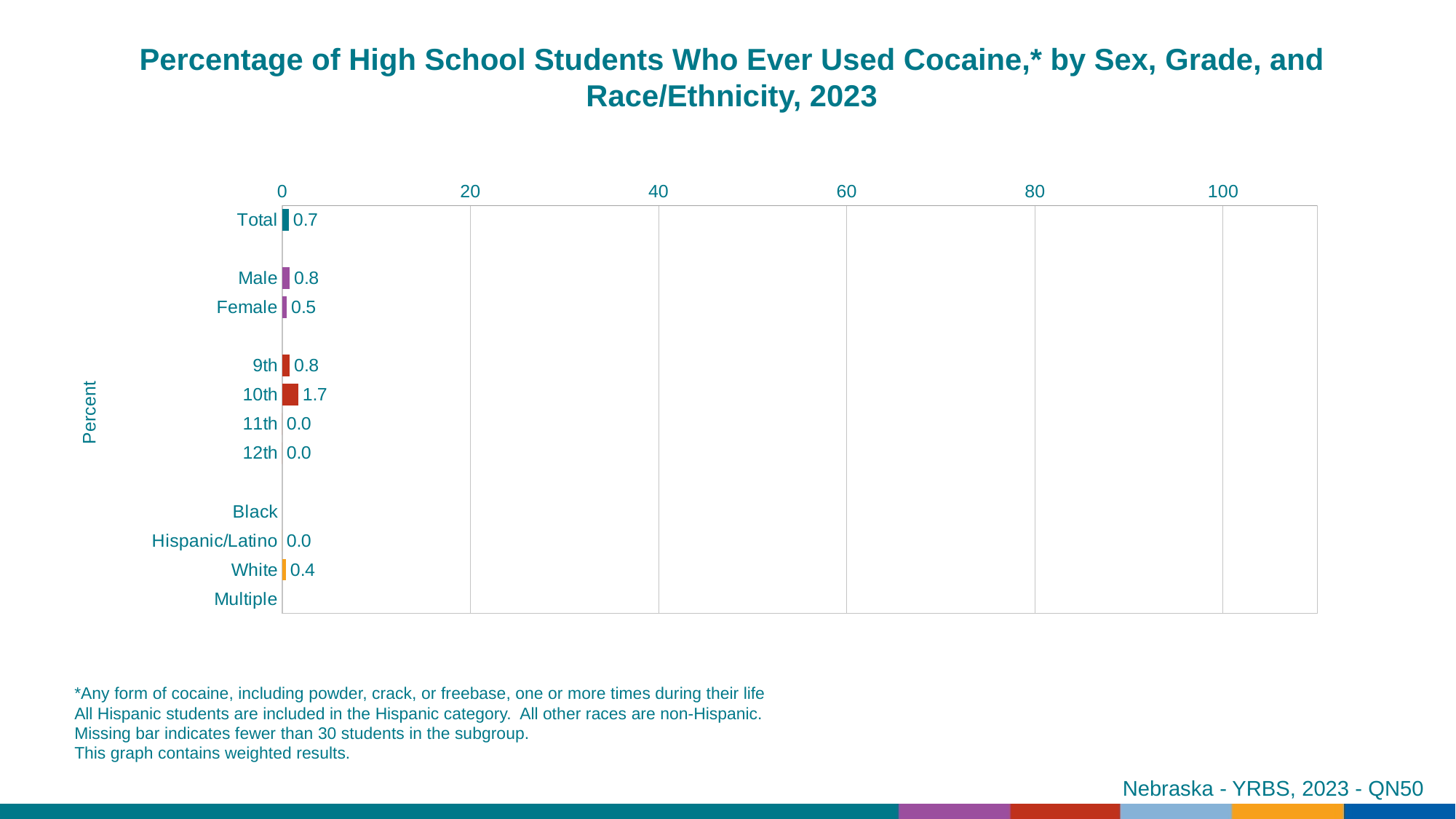
What is the value for White? 0.4 Which is larger, the value for Male or the value for Female? Male What is the difference between the 10th and 9th grade values? 0.9 What is the label on the vertical axis? Percent What is the value for Male? 0.8 What is the value for Female? 0.5 What kind of chart is shown on the slide? Bar chart What is the value for Total? 0.7 Which category has the highest value? 10th What is the value for 10th grade? 1.7 What is the value for 11th grade? 0.0 What is the difference between the Male and Female values? 0.3